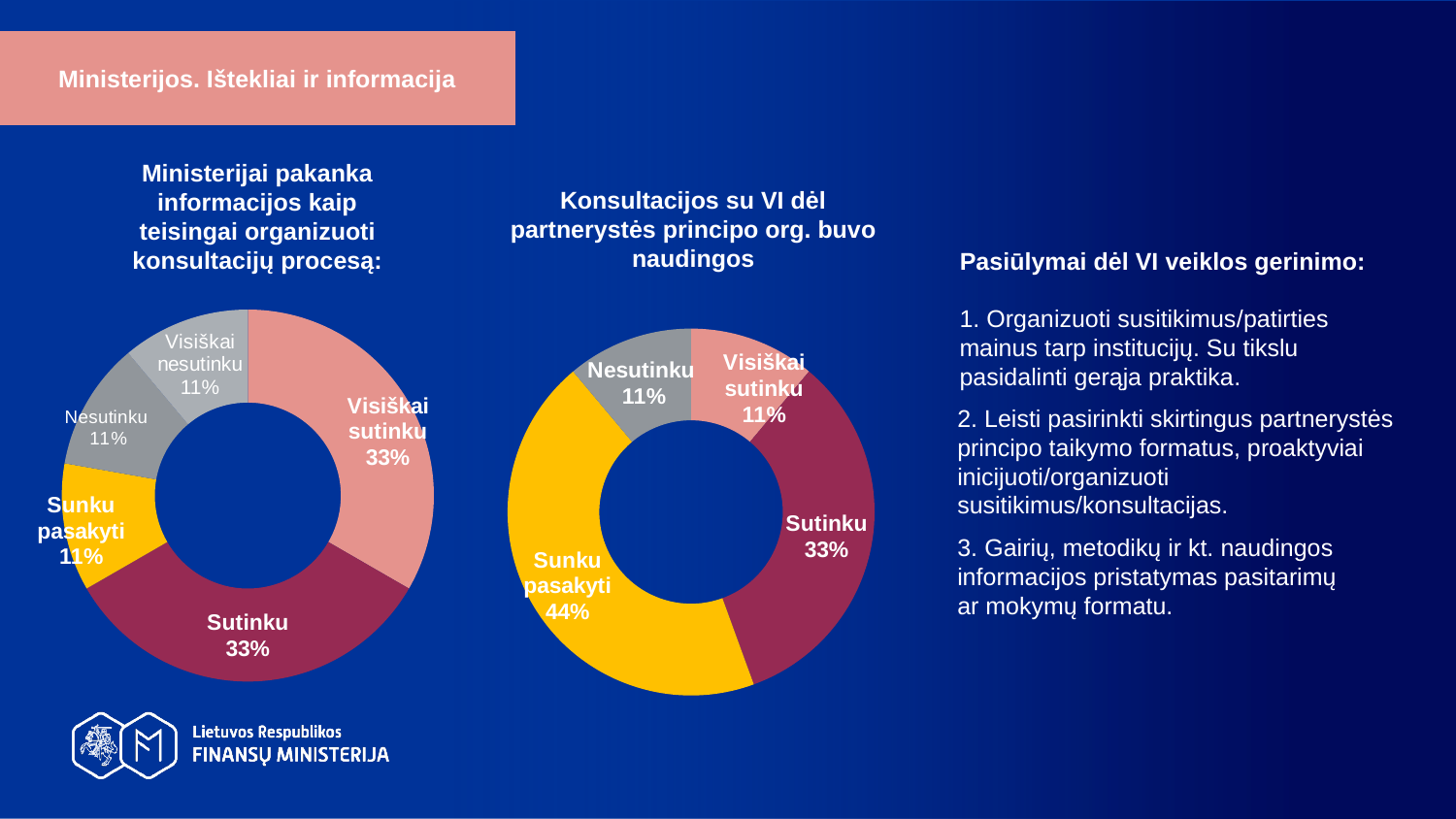
In the left chart ("Ministerijai pakanka informacijos kaip teisingai organizuoti konsultacijų procesą"), what share is labelled for "Sutinku"? 33% In the right chart ("Konsultacijos su VI..."), what share is labelled for "Visiškai sutinku"? 11% In the right chart ("Konsultacijos su VI..."), how many slices does the donut have? 4 In the left chart ("Ministerijai pakanka informacijos..."), what share is labelled for "Visiškai nesutinku"? 11% In the left chart ("Ministerijai pakanka informacijos..."), how many slices does the donut have? 5 What type of chart is used for both charts on the slide? Donut (pie) chart In the left chart ("Ministerijai pakanka informacijos..."), which slice is the smallest: "Sutinku" or "Nesutinku"? Nesutinku In the right chart ("Konsultacijos su VI..."), which category has the largest share? Sunku pasakyti In the right chart ("Konsultacijos su VI dėl partnerystės principo org. buvo naudingos"), what share is labelled for "Sunku pasakyti"? 44% In the right chart ("Konsultacijos su VI..."), what is the difference between the "Sunku pasakyti" share and the "Sutinku" share? 11% In the right chart ("Konsultacijos su VI..."), what colour is the "Sunku pasakyti" slice? Yellow In the left chart ("Ministerijai pakanka informacijos..."), what is the difference between the "Visiškai sutinku" share and the "Sunku pasakyti" share? 22%